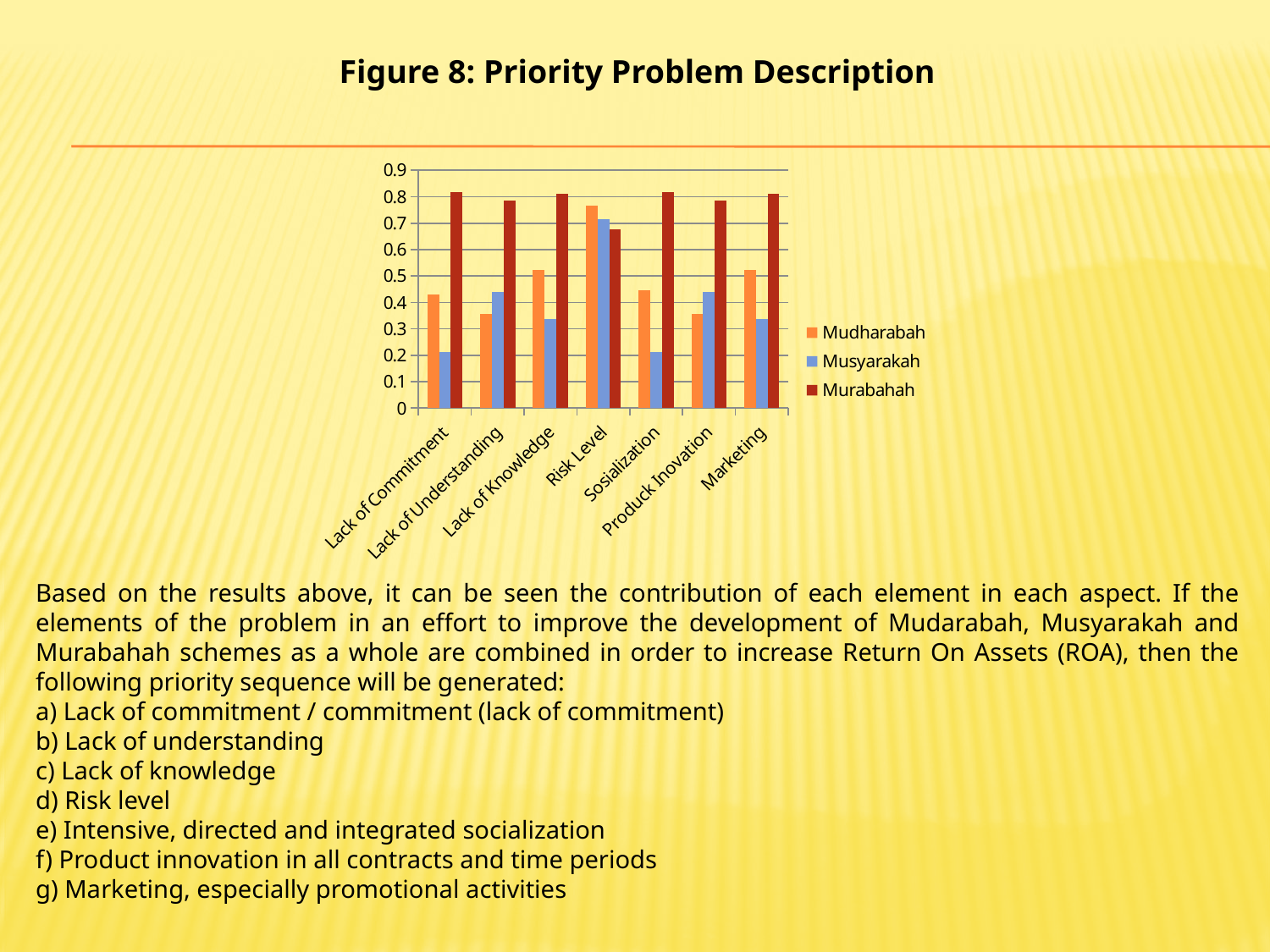
How many categories are shown on the x axis of the chart? 7 What kind of chart is shown on the slide? bar chart Is the Murabahah value for Lack of Commitment greater or less than 0.8? greater Is the Musyarakah value for Sozialization greater or less than 0.3? less Which series is shown in dark red in the chart? Murabahah For which category is the Mudharabah value highest? Risk Level Which is larger for Lack of Knowledge, the Mudharabah value or the Musyarakah value? Mudharabah For which category is the Murabahah value lowest? Risk Level For which category is the Musyarakah value highest? Risk Level How many series does the chart legend list? 3 What is the title of the chart on the slide? Figure 8: Priority Problem Description Which is larger for Risk Level, the Mudharabah value or the Murabahah value? Mudharabah